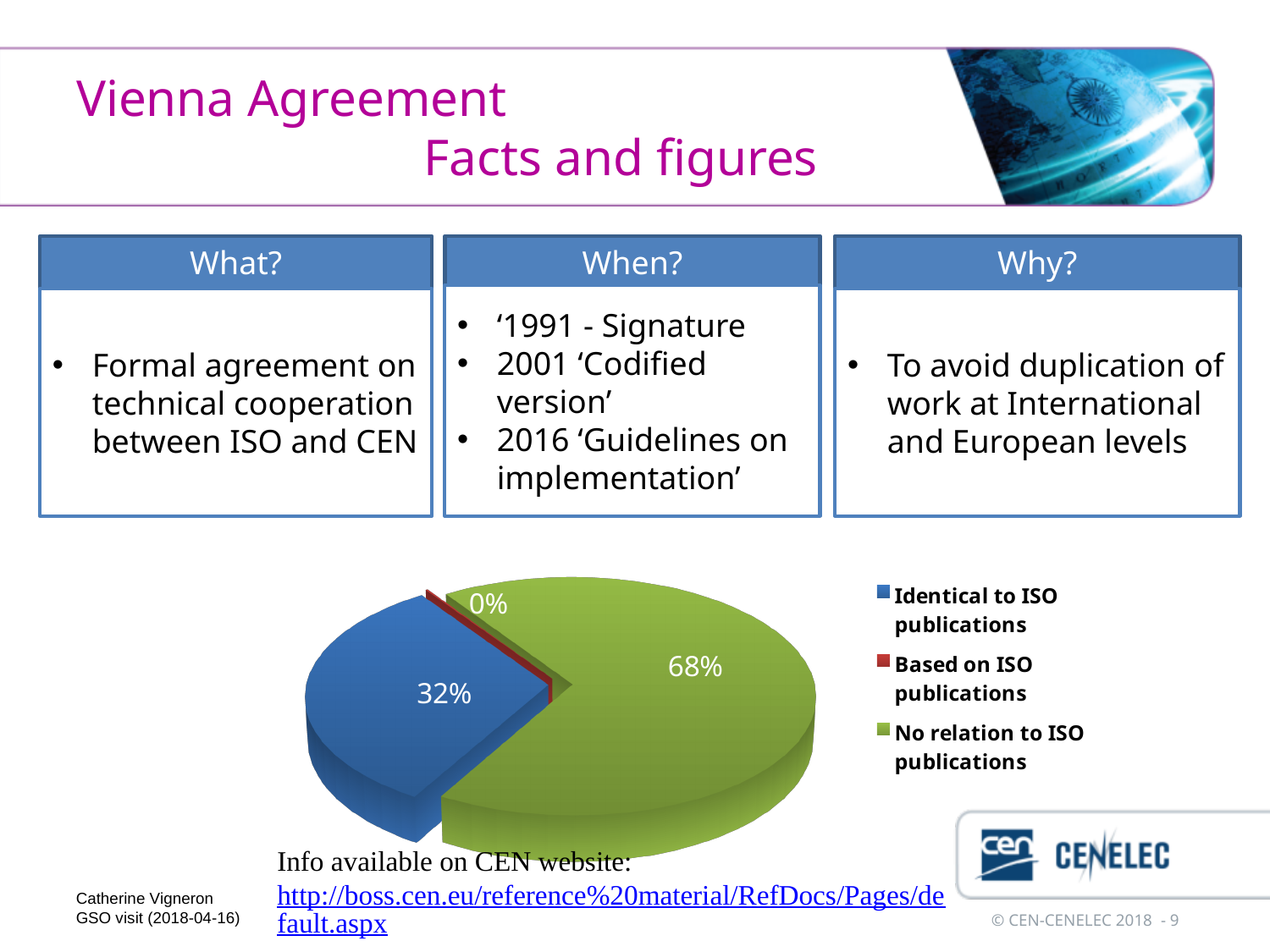
What kind of chart is shown on the slide? pie chart Which is larger: the slice for 'Identical to ISO publications' or the slice for 'No relation to ISO publications'? No relation to ISO publications What is the difference in percentage points between 'No relation to ISO publications' and 'Identical to ISO publications'? 36 What colour is the slice for 'Identical to ISO publications'? blue What colour is the slice for 'No relation to ISO publications'? green Which category has the smallest slice of the pie? Based on ISO publications What share of the pie is labelled 'Based on ISO publications'? 0% How many slices are labelled on the pie chart? 3 What share of the pie is labelled 'Identical to ISO publications'? 32% What share of the pie is labelled 'No relation to ISO publications'? 68% Which category has the largest slice of the pie? No relation to ISO publications How many categories does the legend of the pie chart list? 3